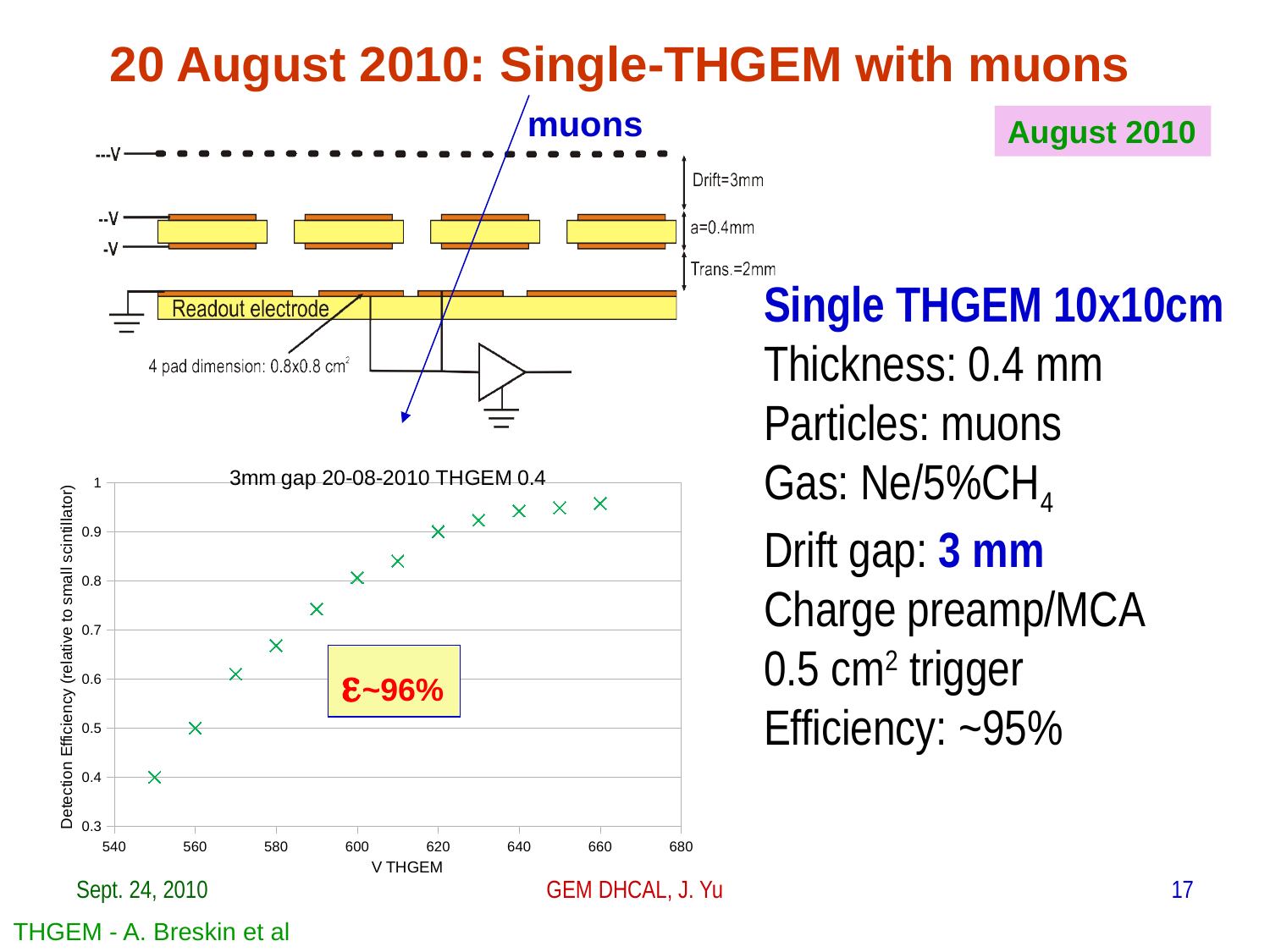
What is the detection efficiency at V THGEM = 560? 0.5 What is the detection efficiency at V THGEM = 550? 0.4 Which has the higher detection efficiency, V THGEM = 590 or V THGEM = 610? 610 What is the label of the x axis of the chart? V THGEM At which V THGEM value is the detection efficiency highest? 660 What kind of chart is shown on the slide? scatter chart Do the detection efficiency values rise or fall as V THGEM increases? rise How many data points are plotted in the chart? 12 Is the detection efficiency at V THGEM = 580 greater or less than 0.7? less What is the title of the chart? 3mm gap 20-08-2010 THGEM 0.4 At which V THGEM value is the detection efficiency lowest? 550